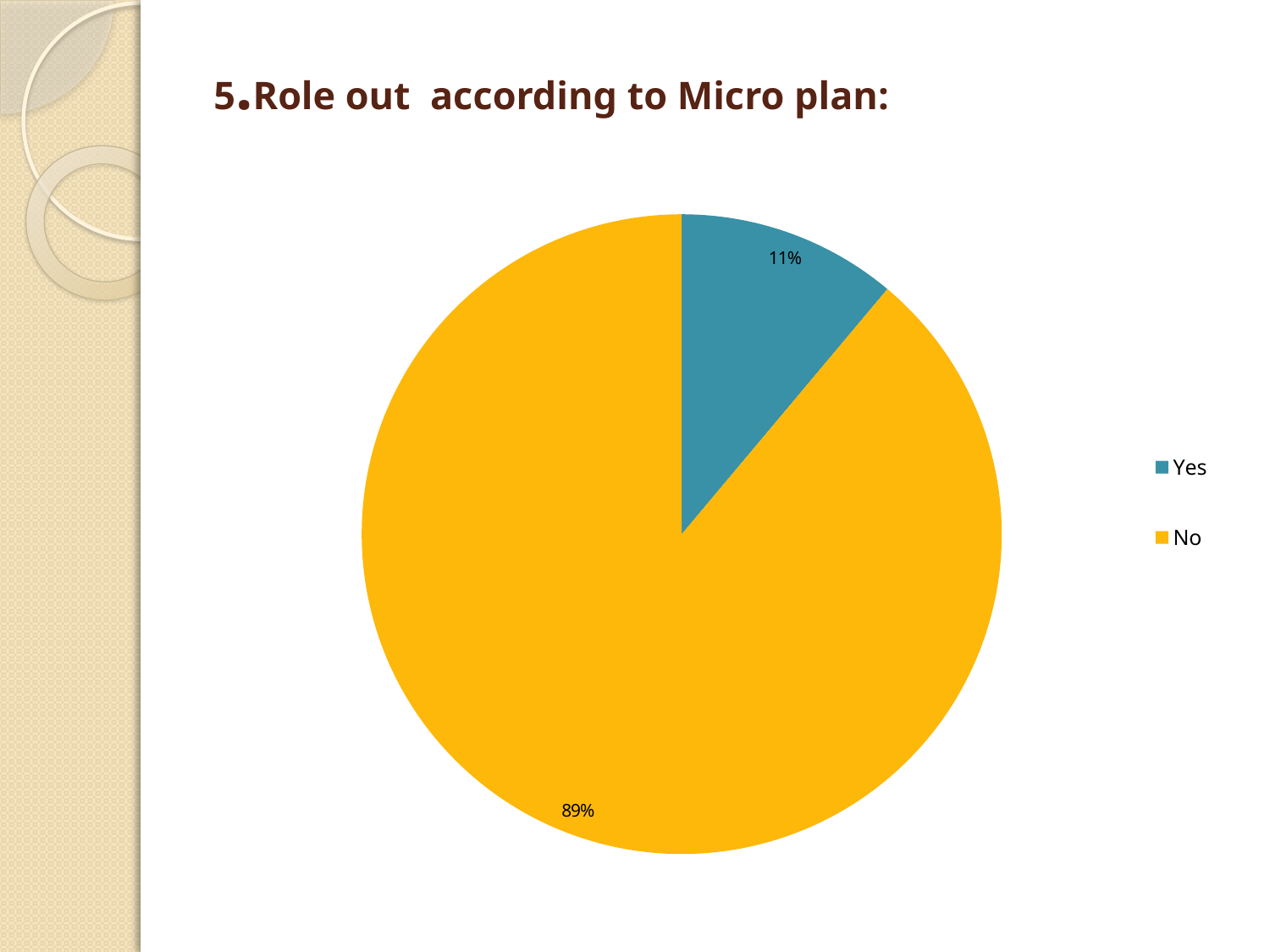
Which category has the largest share of the pie? No What is the difference in percentage points between the "No" and "Yes" slices? 78 What kind of chart is shown on the slide? pie chart Which slice is larger, "Yes" or "No"? No How many categories does the pie chart show? 2 How many entries does the legend list? 2 What is the title shown above the chart? 5.Role out according to Micro plan: Which category has the smallest share of the pie? Yes What percentage of the pie is labelled "Yes"? 11% What percentage of the pie is labelled "No"? 89% What share of the pie does the "No" slice take? 89% What colour is the "Yes" slice? teal blue